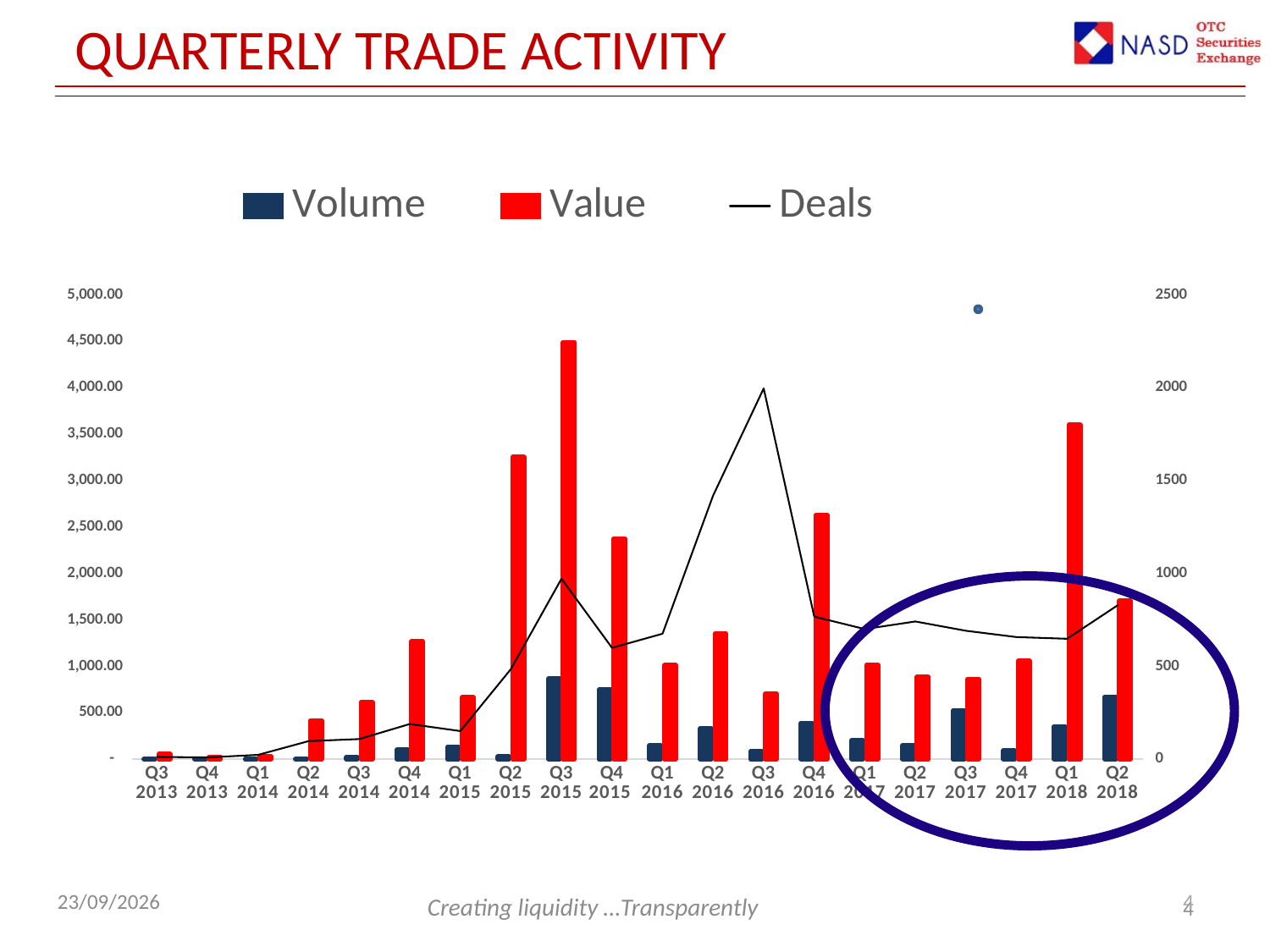
Is the Value for Q3 2015 greater or less than 4,000.00? greater Which has the larger Value bar, Q1 2018 or Q2 2018? Q1 2018 In which quarter does the Deals line reach its peak? Q3 2016 Is the Value for Q1 2018 greater or less than 3,000.00? greater What colour are the Value bars in the chart? Red Which has the larger Value bar, Q2 2015 or Q4 2015? Q2 2015 In which quarter is the Value bar highest? Q3 2015 Is the Deals value for Q3 2016 greater or less than 1500 on the right axis? greater How many series does the legend list? 3 How many quarters are shown on the x axis? 20 What kind of chart is shown on the slide? Bar chart with a line